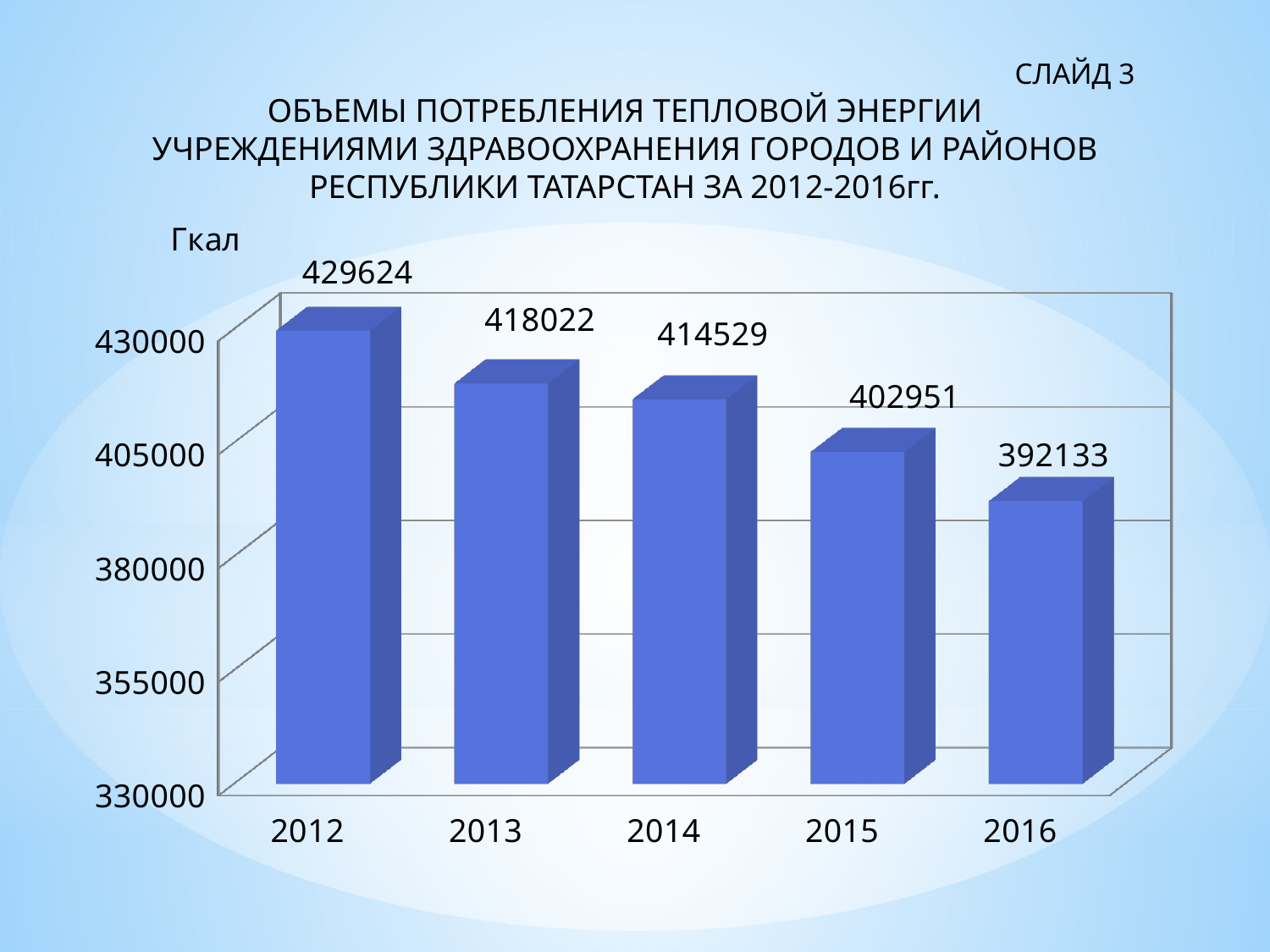
What is the heat energy consumption value shown for 2012? 429624 What is the value shown for 2016? 392133 What value is labelled on the bar for 2014? 414529 Which year has the highest value on the chart? 2012 What kind of chart is shown on the slide? bar chart How many years are shown on the x axis of the chart? 5 What is the difference between the values for 2012 and 2016? 37491 Which year has the lowest value on the chart? 2016 Is the value for 2015 greater or less than 405000? less Which is larger, the value for 2015 or the value for 2016? 2015 Do the values rise or fall from 2012 to 2016? fall What is the difference between the values for 2013 and 2014? 3493